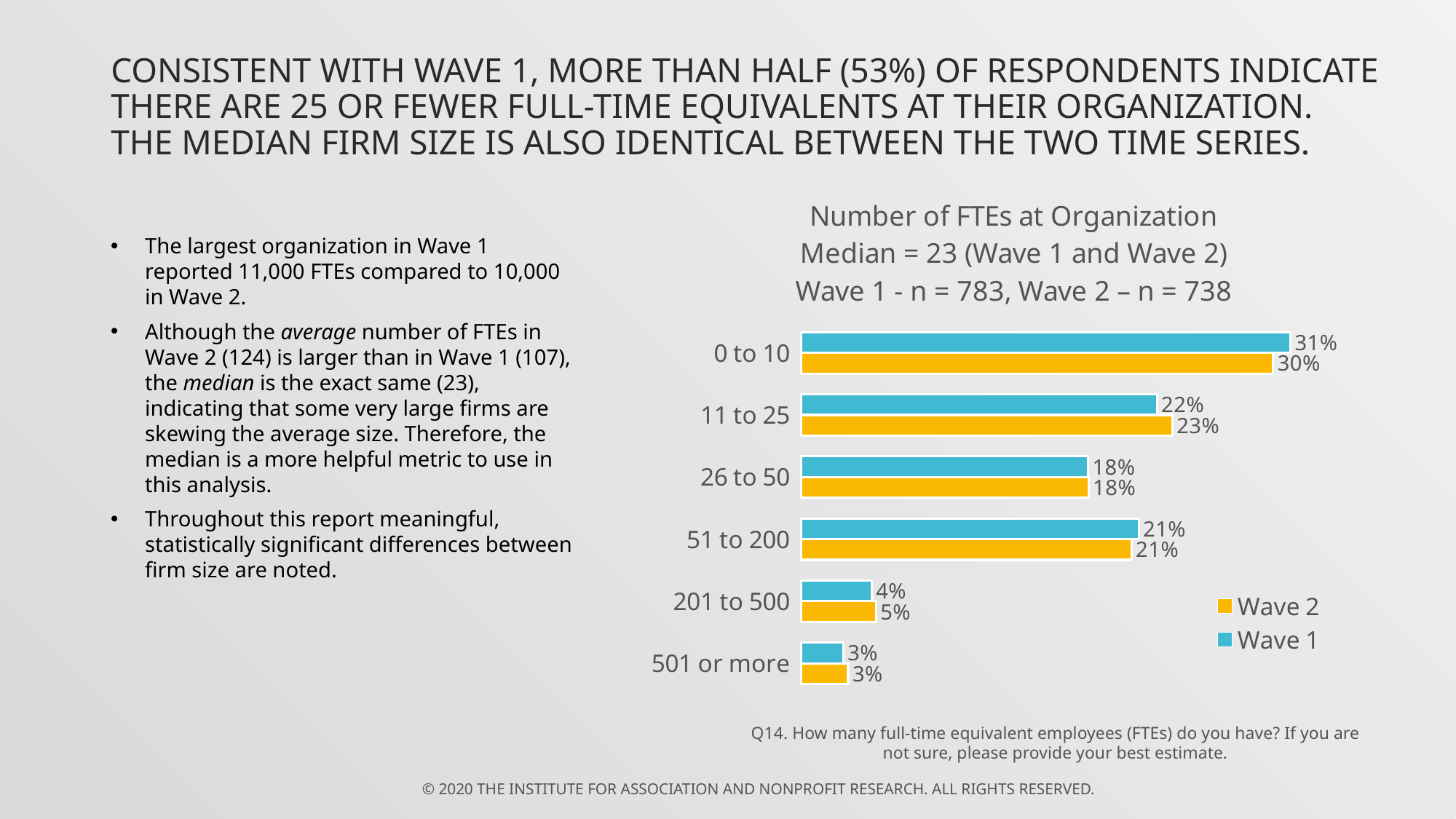
What kind of chart is shown on the slide? Bar chart What colour represents Wave 2 in the chart? Yellow Which is larger for the 11 to 25 category, Wave 1 or Wave 2? Wave 2 How many series does the legend list? 2 What is the difference between the Wave 1 and Wave 2 values for the 0 to 10 category? 1% How many categories are shown on the chart? 6 What is the Wave 2 value for the 201 to 500 category? 5% What is the Wave 2 value for the 11 to 25 category? 23% What is the difference between the Wave 2 values for 0 to 10 and 11 to 25? 7% What is the Wave 1 value for the 0 to 10 category? 31% Which category has the lowest Wave 2 value? 501 or more Which category has the highest Wave 1 value? 0 to 10